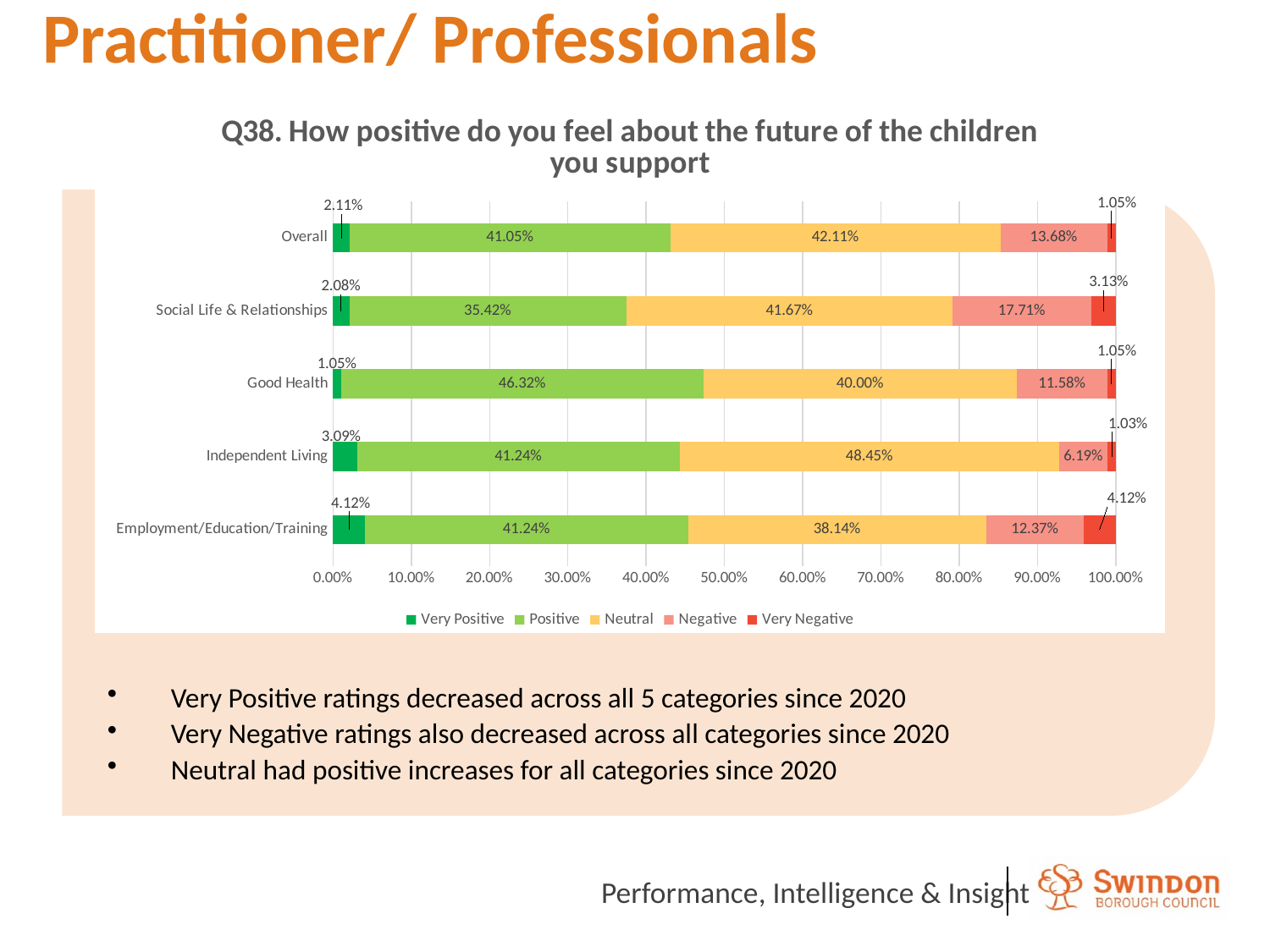
Which is larger, the Positive value for Good Health or the Positive value for Social Life & Relationships? Good Health What kind of chart is this? Stacked bar chart What is the Neutral value for Overall? 42.11% How many series does the legend list? 5 Which category has the lowest Negative value? Independent Living What is the Positive value for Good Health? 46.32% What is the difference between the Neutral and Positive values for Overall? 1.06% How many categories are shown on the chart? 5 What colour represents the Neutral series in the chart? Yellow What is the Very Positive value for Employment/Education/Training? 4.12% Which category has the highest Neutral value? Independent Living What is the Negative value for Social Life & Relationships? 17.71%